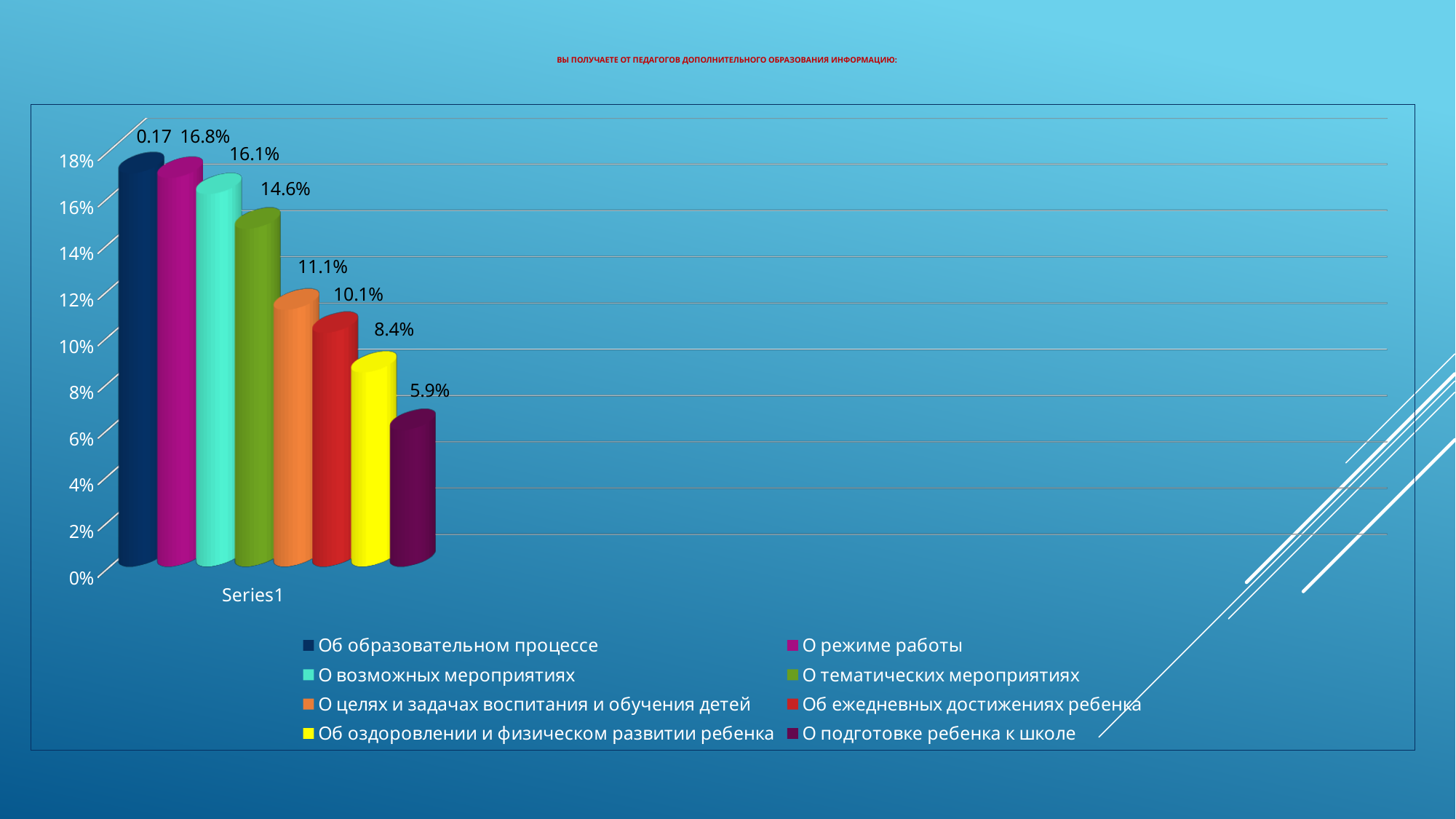
Which category has the lowest value? О подготовке ребенка к школе Is the value for 'Об оздоровлении и физическом развитии ребенка' greater or less than 10%? less What is the difference between 'О режиме работы' and 'О возможных мероприятиях'? 0.7% What is the value for 'Об ежедневных достижениях ребенка'? 10.1% What is the value for 'О подготовке ребенка к школе'? 5.9% What kind of chart is shown on the slide? bar chart What is the difference between 'О тематических мероприятиях' and 'Об оздоровлении и физическом развитии ребенка'? 6.2% Which is larger: 'О целях и задачах воспитания и обучения детей' or 'Об ежедневных достижениях ребенка'? О целях и задачах воспитания и обучения детей What is the value for 'О режиме работы'? 16.8% What is the value for 'О тематических мероприятиях'? 14.6% How many entries does the legend list? 8 What data label is shown on the bar for 'Об образовательном процессе'? 0.17